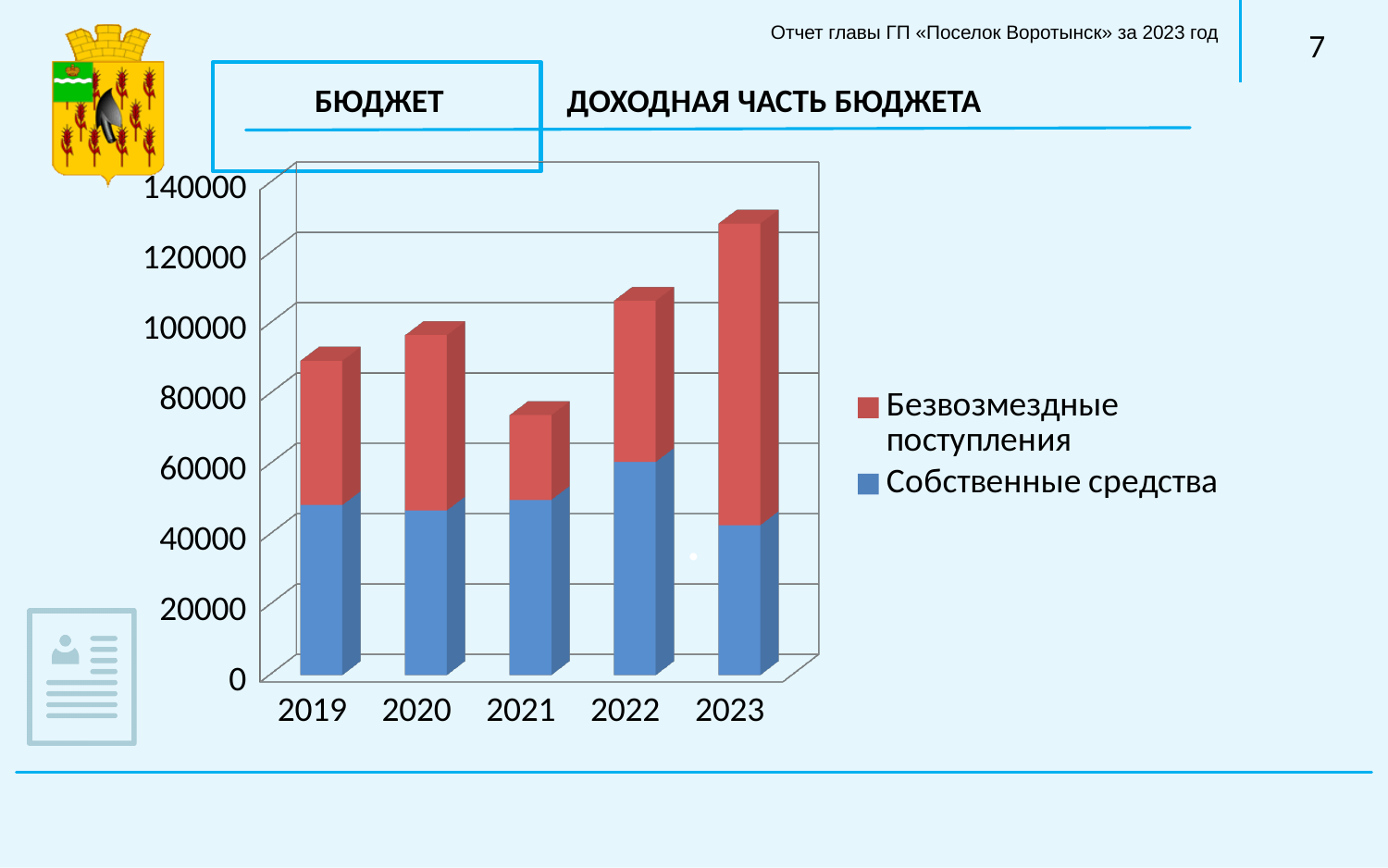
How many years are shown on the x axis of the chart? 5 Which series is shown in red in the chart? Безвозмездные поступления How many series does the chart legend list? 2 Is the Собственные средства value for 2022 greater or less than 40000? greater Do the total bar values rise or fall from 2021 to 2023? rise Is the total value for 2022 greater or less than 100000? greater What kind of chart is shown on the slide? stacked bar chart Which year has the highest total bar in the chart? 2023 Is the total value for 2021 greater or less than 80000? less Which year has a larger total bar, 2020 or 2021? 2020 Which year has the lowest total bar in the chart? 2021